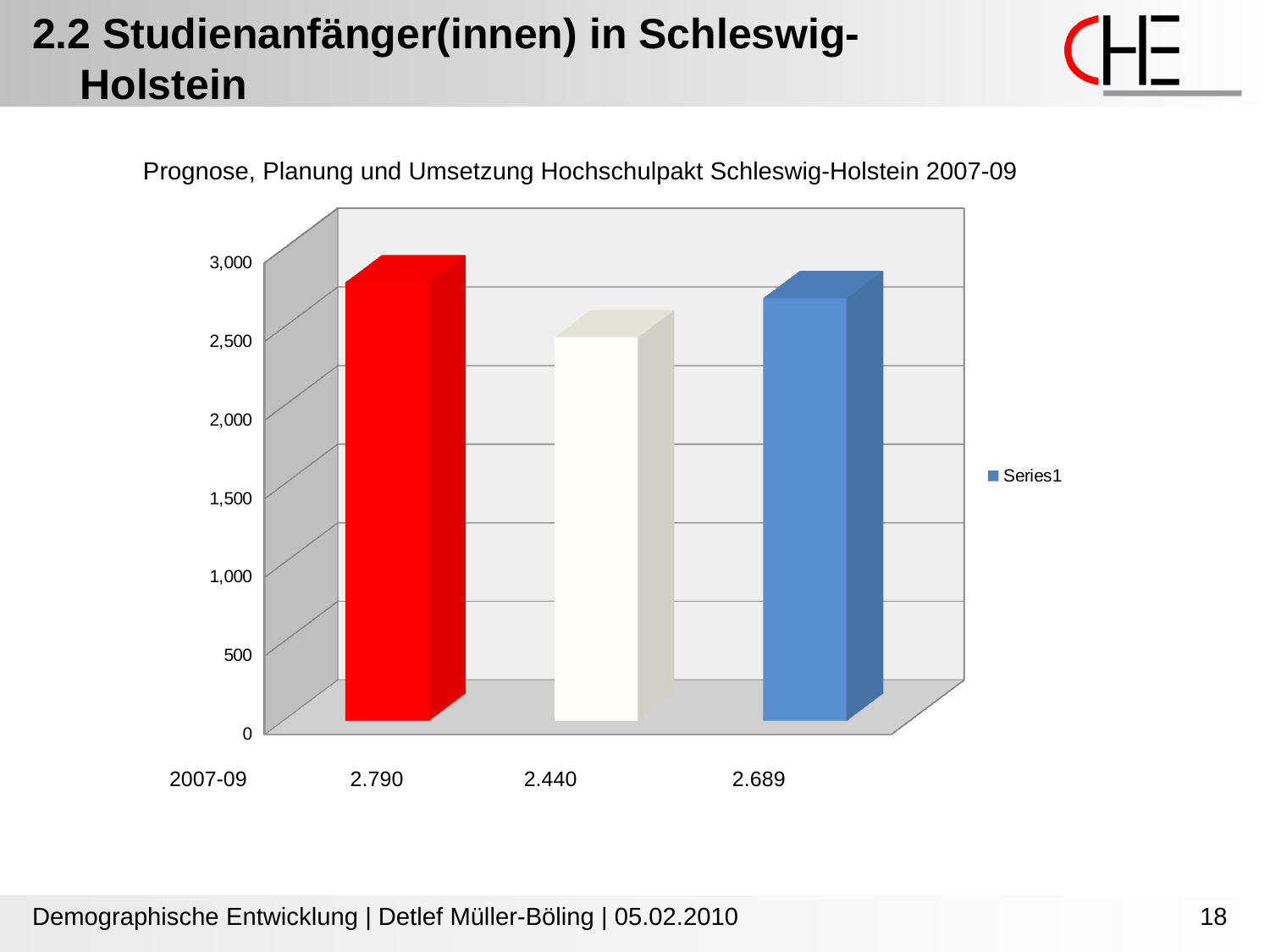
What is the legend entry shown next to the chart? Series1 What is the title of the chart? Prognose, Planung und Umsetzung Hochschulpakt Schleswig-Holstein 2007-09 Is the value of the white bar greater or less than 2,500? less Which bar is the shortest in the chart? the white bar Which is larger, the red bar or the white bar? the red bar What kind of chart is shown on the slide? bar chart Which bar is the tallest in the chart? the red bar Is the value of the red bar greater or less than 2,500? greater Is the value of the blue bar greater or less than 2,500? greater What label is printed beneath the white (middle) bar? 2.440 How many series does the legend list? 1 How many bars are plotted in the chart? 3